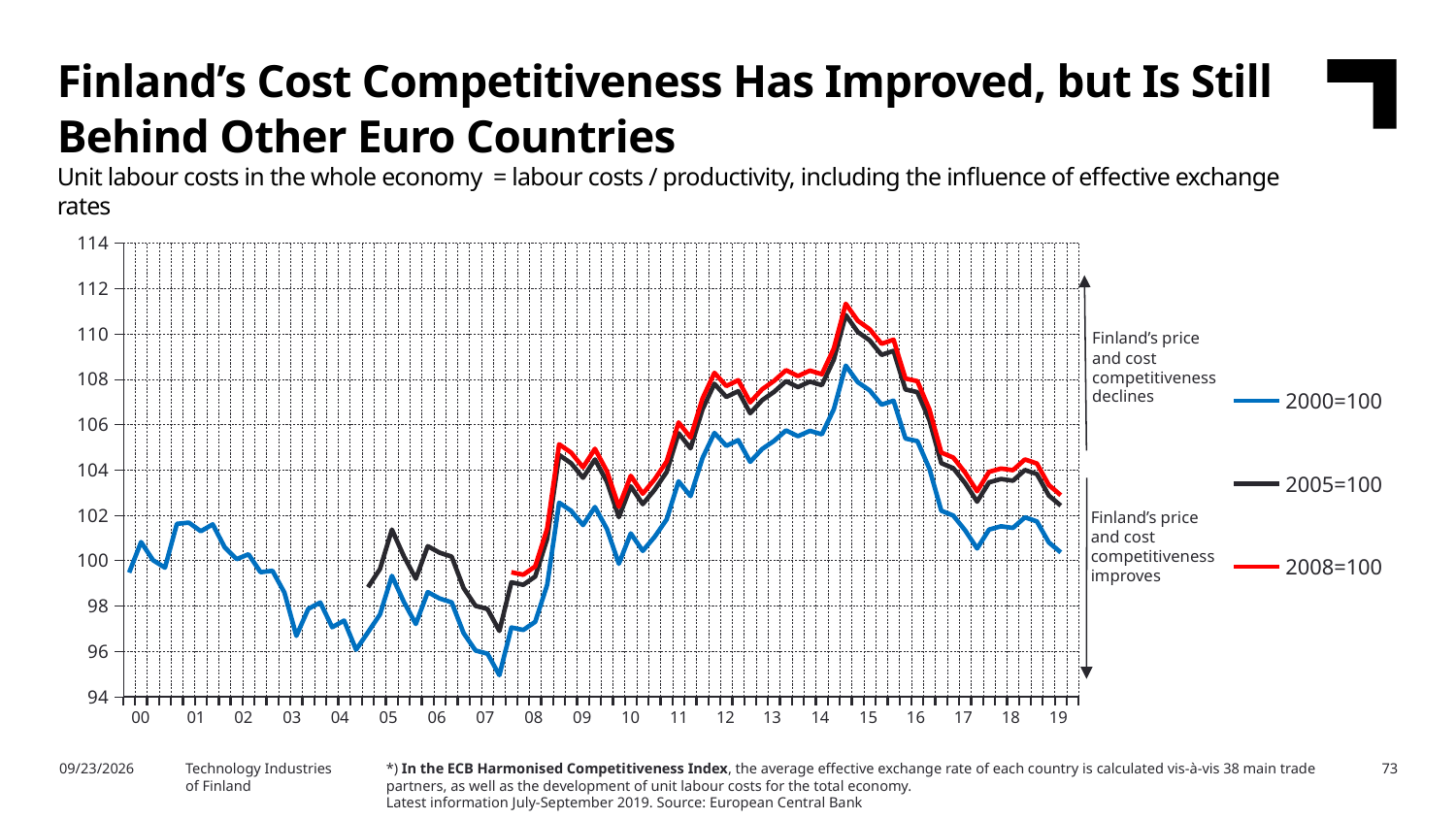
How many years are labelled along the x axis? 20 What is the lowest value shown on the vertical axis? 94 What are the three series named in the legend? 2000=100, 2005=100, 2008=100 In 2015, which series is higher, 2000=100 or 2008=100? 2008=100 Is the value of the 2000=100 series in 2019 greater or less than 102? less Which series has the lowest value in 2019? 2000=100 Do the values of the series rise or fall between 2015 and 2017? Fall What kind of chart is shown on the slide? Line chart Is the peak value of the 2008=100 series around 2015 greater or less than 110? greater Is the lowest value of the 2000=100 series around 2007 greater or less than 96? less How many series does the legend list? 3